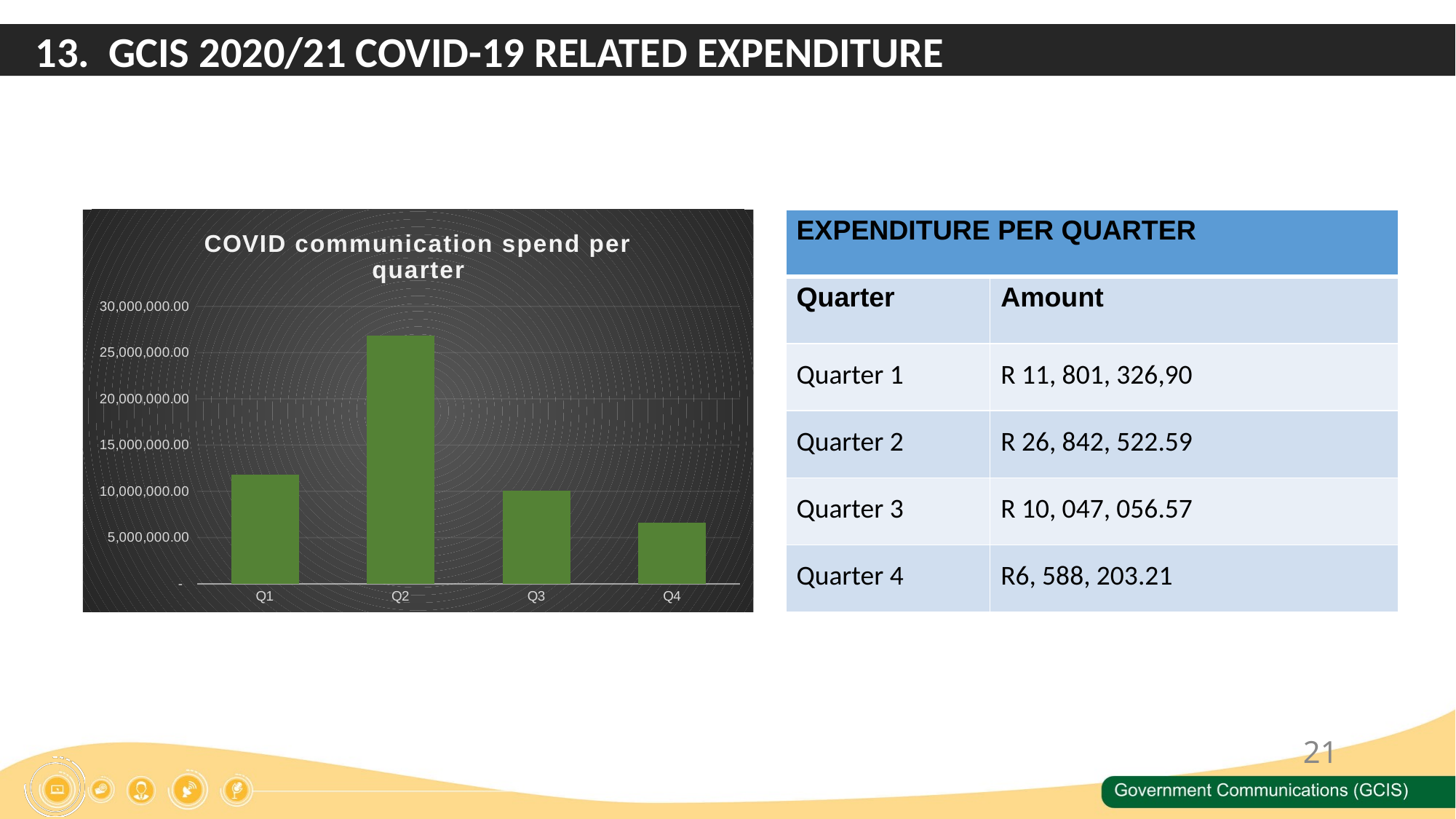
What is the title of the chart? COVID communication spend per quarter According to the expenditure table, what is the amount for Quarter 2? R 26, 842, 522.59 Which quarter has the highest COVID communication spend? Q2 Which quarter has the lowest COVID communication spend? Q4 Is the value for Q2 greater or less than 25,000,000.00? greater From Q2 to Q4, do the values rise or fall? fall Which is larger, the spend for Q1 or the spend for Q3? Q1 Is the value for Q3 greater or less than 15,000,000.00? less What type of chart is shown on the slide? bar chart Is the value for Q1 greater or less than 10,000,000.00? greater How many quarters are plotted on the chart? 4